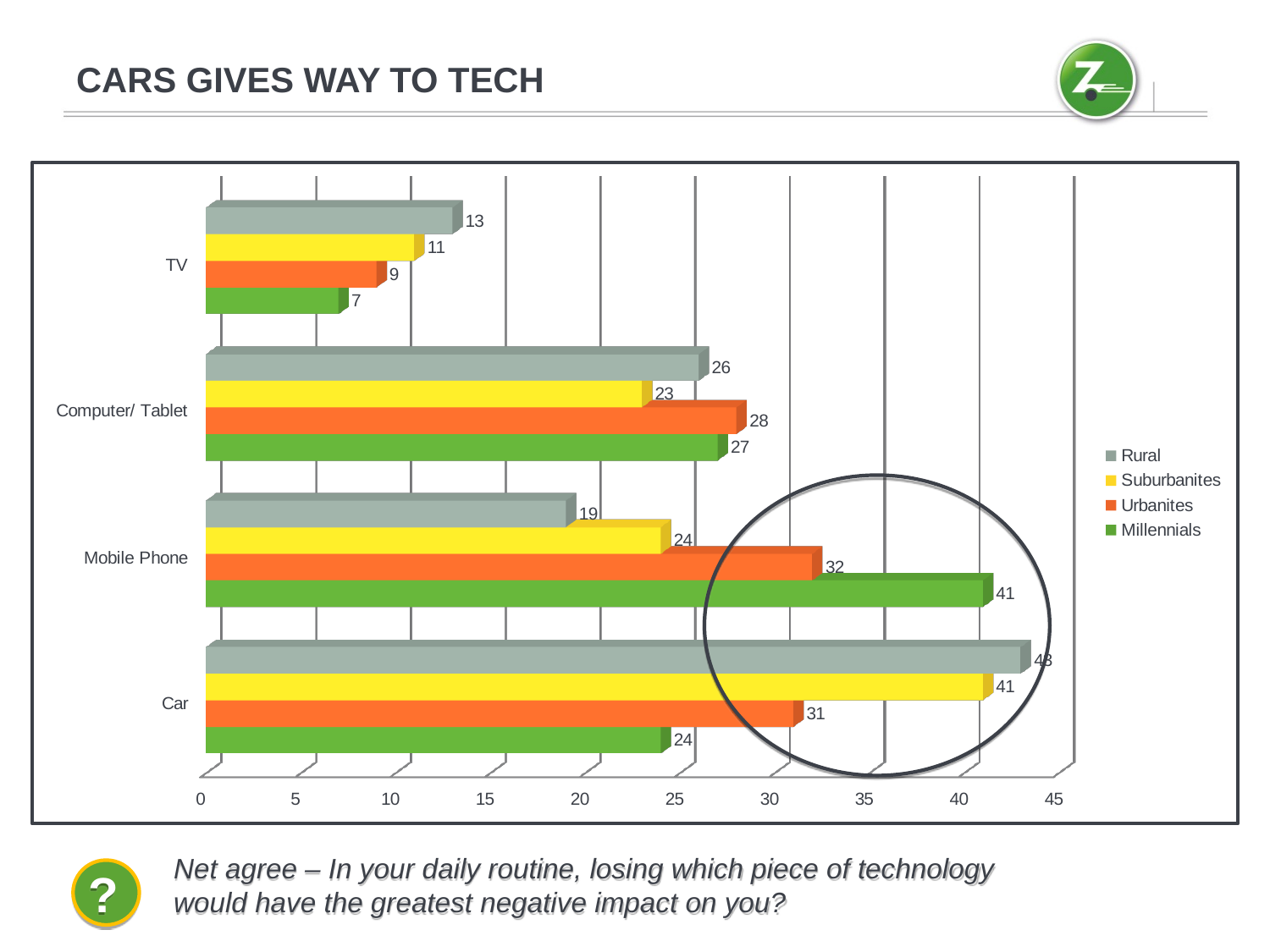
How many categories are shown on the chart? 4 What is the difference between the Millennials value for Mobile Phone and the Millennials value for Car? 17 Which is larger for Mobile Phone: the Rural value or the Suburbanites value? Suburbanites Which category has the lowest Millennials value? TV What is the Urbanites value for Computer/ Tablet? 28 Is the Rural value for Car greater or less than 40? greater How many series does the legend list? 4 Which category has the highest Urbanites value? Mobile Phone What is the Suburbanites value for Car? 41 What is the Millennials value for Mobile Phone? 41 Which legend entry is shown in green? Millennials What kind of chart is shown on the slide? bar chart